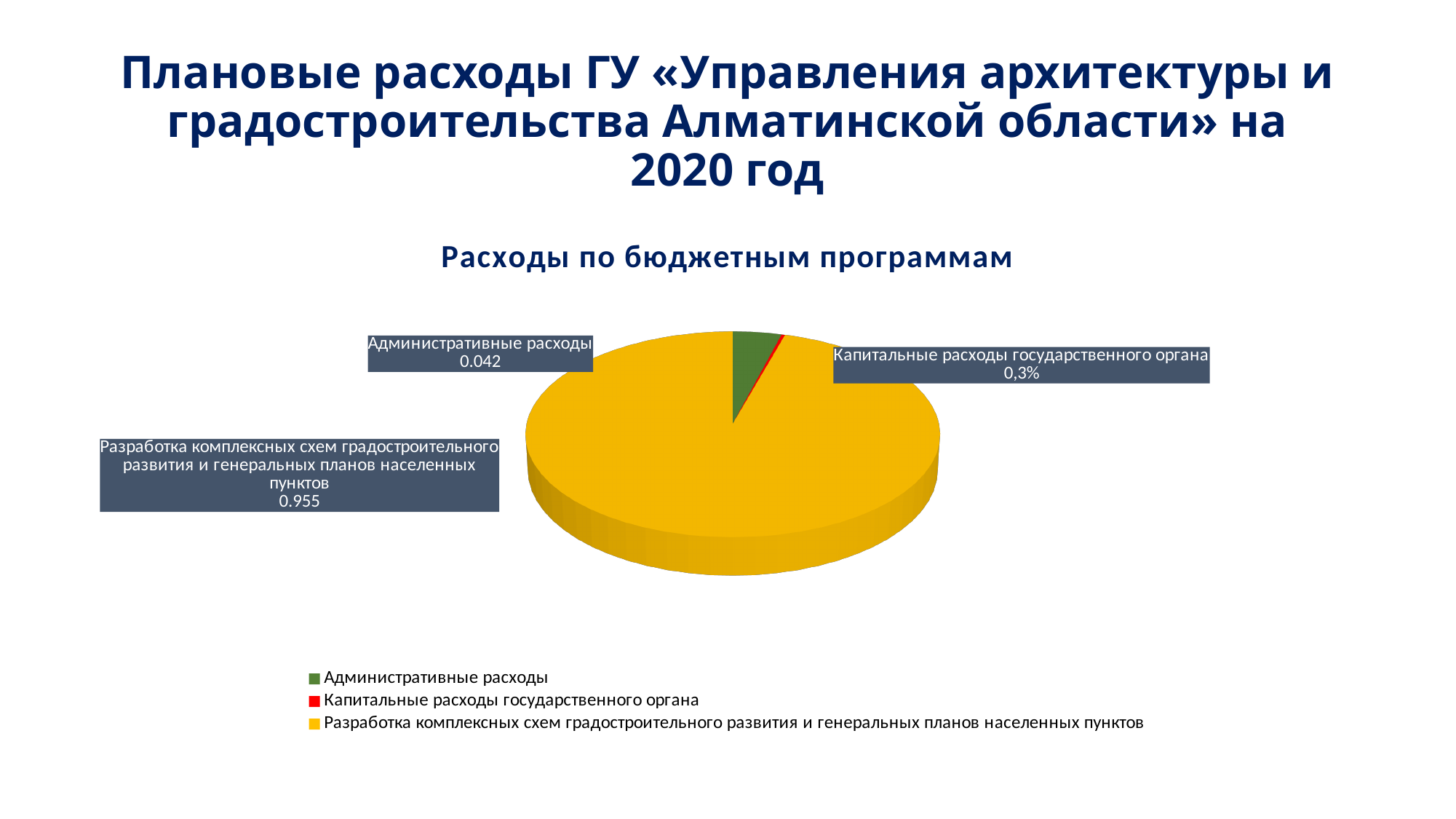
Which is larger: Административные расходы or Капитальные расходы государственного органа? Административные расходы What kind of chart is shown on the slide? Pie chart What value is shown for Разработка комплексных схем градостроительного развития и генеральных планов населенных пунктов? 0.955 What is the difference between the values for Разработка комплексных схем градостроительного развития и генеральных планов населенных пунктов and Административные расходы? 0.913 What value is shown for Административные расходы in the pie chart? 0.042 What value is shown for Капитальные расходы государственного органа in the pie chart? 0,3% Which category has the largest slice of the pie chart? Разработка комплексных схем градостроительного развития и генеральных планов населенных пунктов How many slices does the pie chart have? 3 How many entries does the legend list? 3 What colour represents Административные расходы in the pie chart? Green What is the title of the chart? Расходы по бюджетным программам Which category has the smallest slice of the pie chart? Капитальные расходы государственного органа